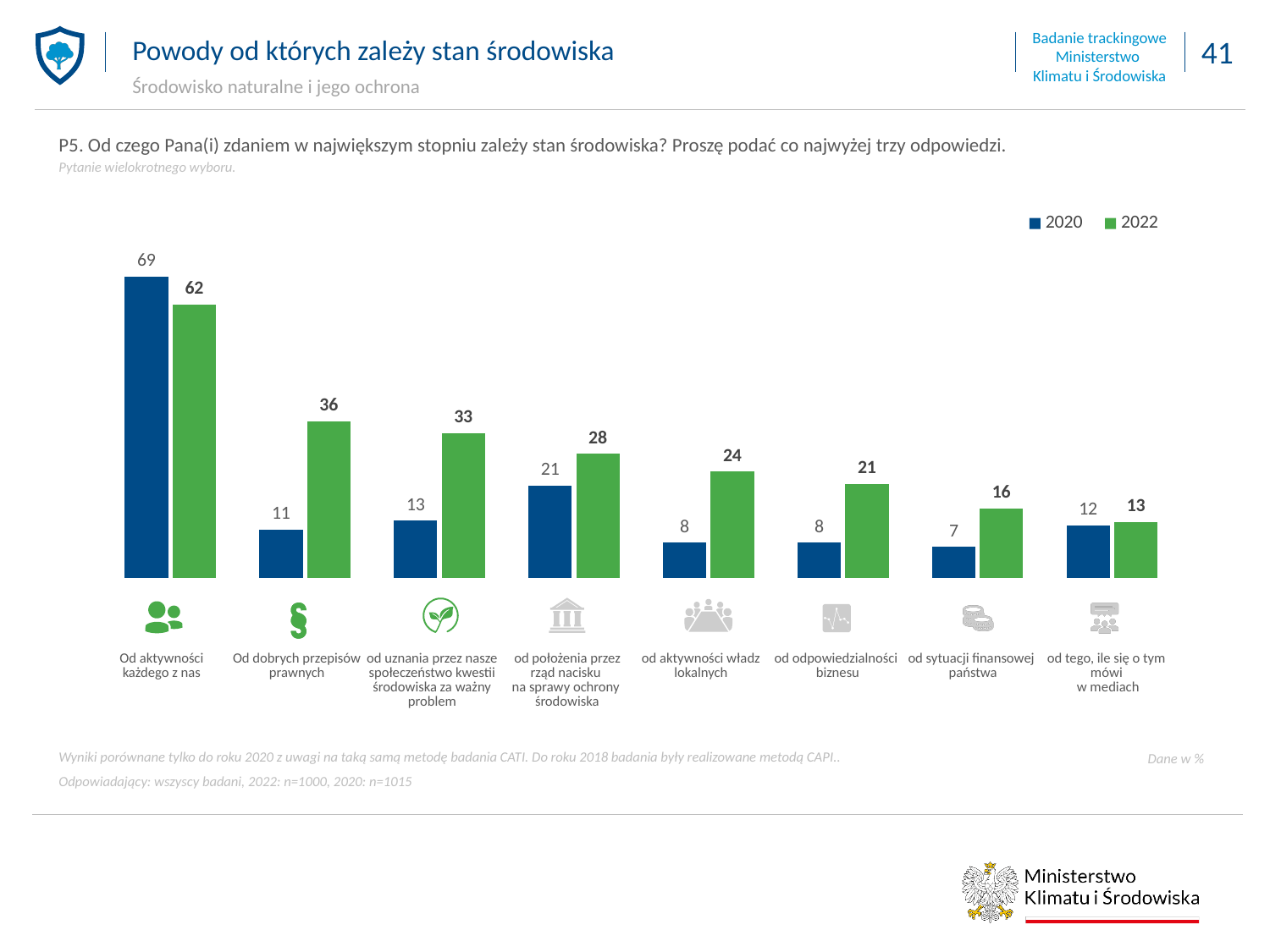
How many categories are shown on the x axis? 8 How many series does the legend list? 2 What is the 2020 value for "od tego, ile się o tym mówi w mediach"? 12 What is the 2020 value for "Od dobrych przepisów prawnych"? 11 What is the 2022 value for "Od aktywności każdego z nas"? 62 Which category has the highest 2020 value? Od aktywności każdego z nas What is the difference between the 2022 and 2020 values for "Od dobrych przepisów prawnych"? 25 What is the 2022 value for "od położenia przez rząd nacisku na sprawy ochrony środowiska"? 28 Which category has the lowest 2020 value? od sytuacji finansowej państwa Which is larger for "od aktywności władz lokalnych": the 2020 value or the 2022 value? 2022 Which years are listed in the legend? 2020 and 2022 What kind of chart is shown on the slide? bar chart